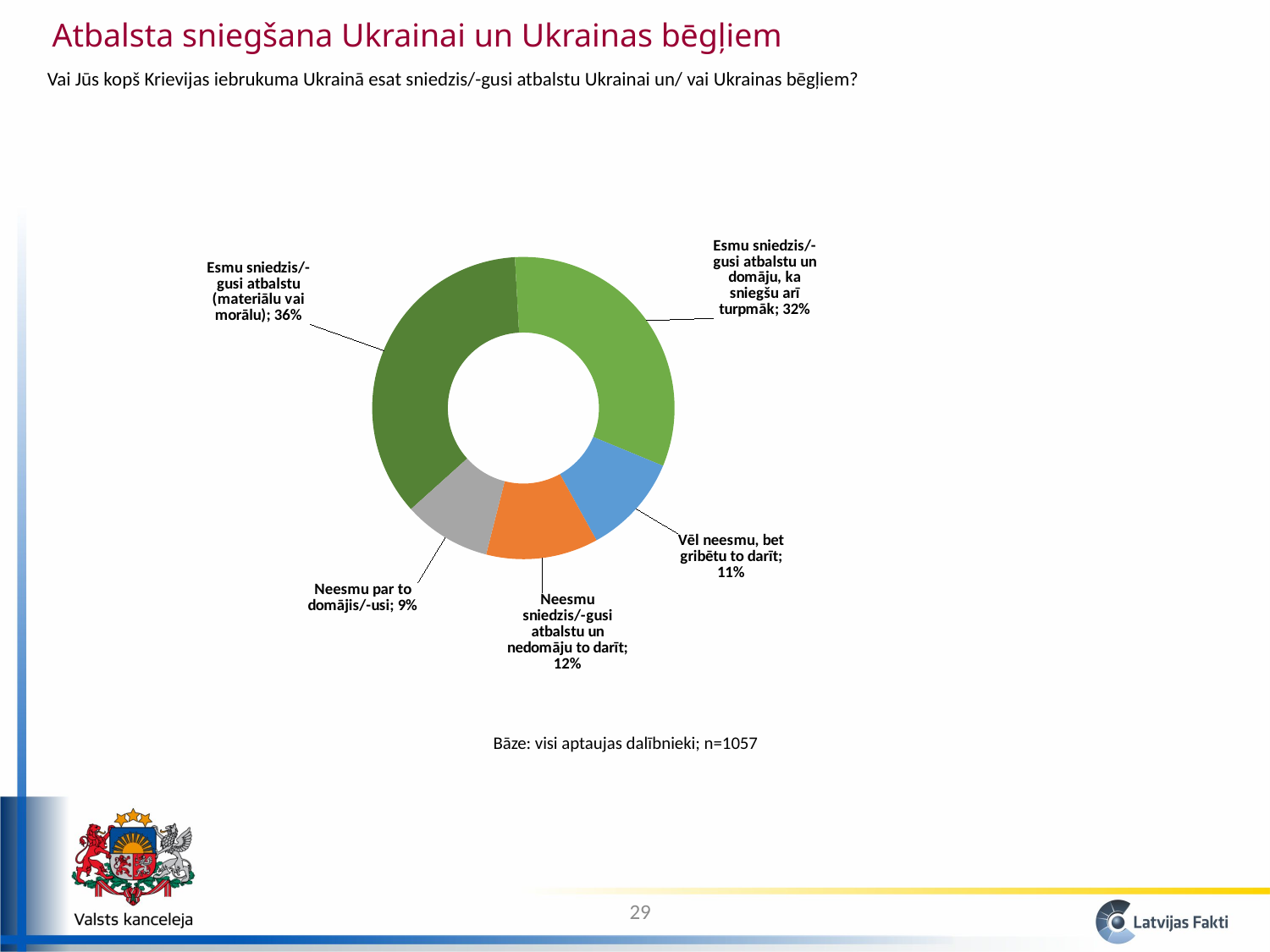
What is the base (n) of respondents stated below the chart? n=1057 What share of respondents answered "Vēl neesmu, bet gribētu to darīt"? 11% What share of respondents answered "Neesmu par to domājis/-usi"? 9% What kind of chart is shown on the slide? Doughnut (pie) chart Which answer category has the largest share in the chart? Esmu sniedzis/-gusi atbalstu (materiālu vai morālu) Which answer category has the smallest share in the chart? Neesmu par to domājis/-usi How many answer categories are shown in the chart? 5 Which is larger: the share for "Neesmu sniedzis/-gusi atbalstu un nedomāju to darīt" or for "Vēl neesmu, bet gribētu to darīt"? Neesmu sniedzis/-gusi atbalstu un nedomāju to darīt What share of respondents answered "Esmu sniedzis/-gusi atbalstu un domāju, ka sniegšu arī turpmāk"? 32% What is the difference in percentage points between "Esmu sniedzis/-gusi atbalstu (materiālu vai morālu)" and "Esmu sniedzis/-gusi atbalstu un domāju, ka sniegšu arī turpmāk"? 4 percentage points What share of respondents answered "Esmu sniedzis/-gusi atbalstu (materiālu vai morālu)"? 36% What share of respondents answered "Neesmu sniedzis/-gusi atbalstu un nedomāju to darīt"? 12%